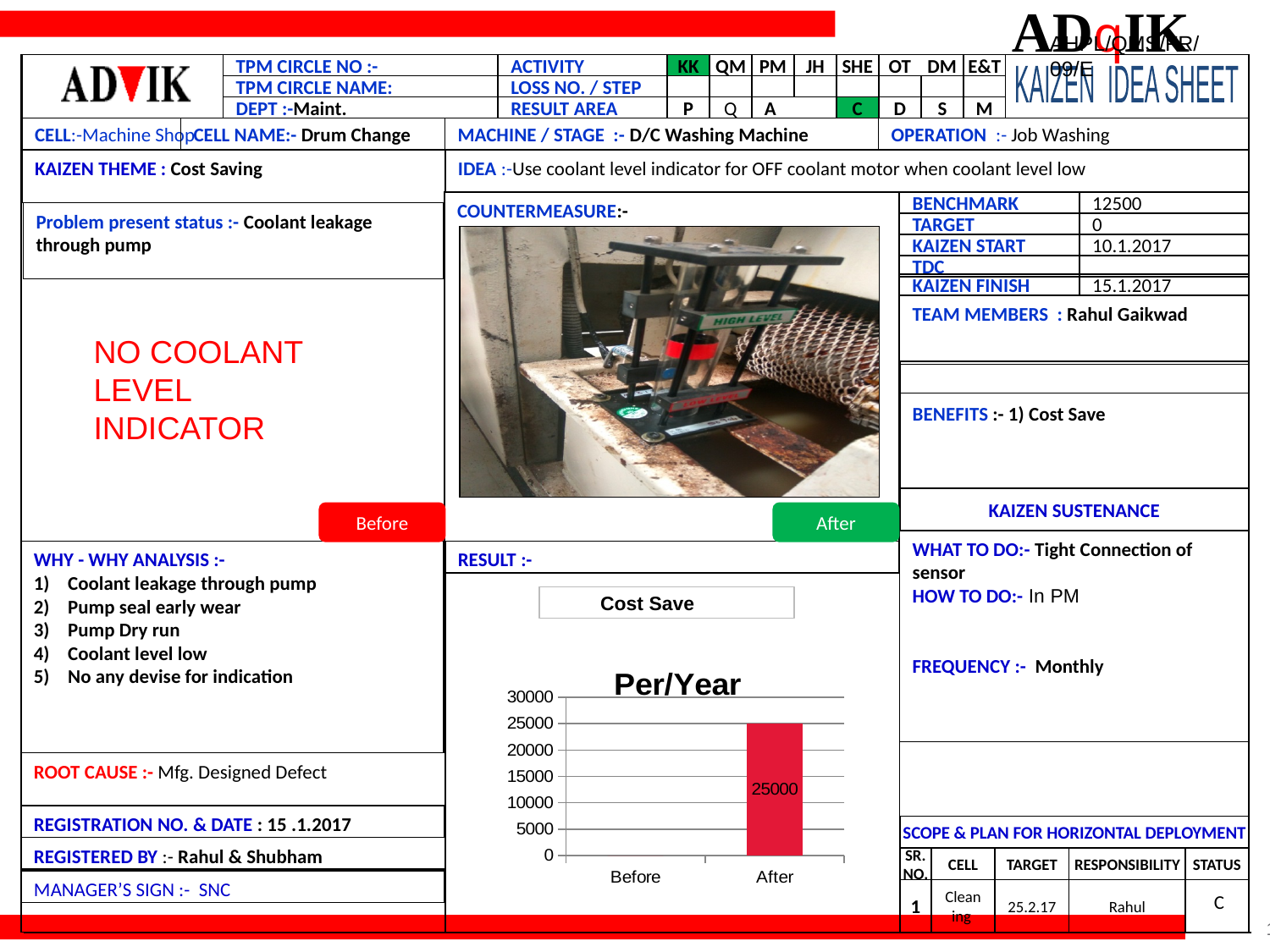
What is the highest value shown on the y axis of the Per/Year chart? 30000 What kind of chart is the Per/Year chart? bar chart What is the title of the chart in the RESULT section? Per/Year Is the value for After in the Per/Year chart greater or less than 30000? less How many categories are shown on the x axis of the Per/Year chart? 2 What is the value for After in the Per/Year chart? 25000 Which category has the lowest value in the Per/Year chart? Before Do the values in the Per/Year chart rise or fall from Before to After? rise What colour is the After bar in the Per/Year chart? red Which category has the highest value in the Per/Year chart? After Is the value for After in the Per/Year chart greater or less than 20000? greater In the Per/Year chart, which is larger, Before or After? After